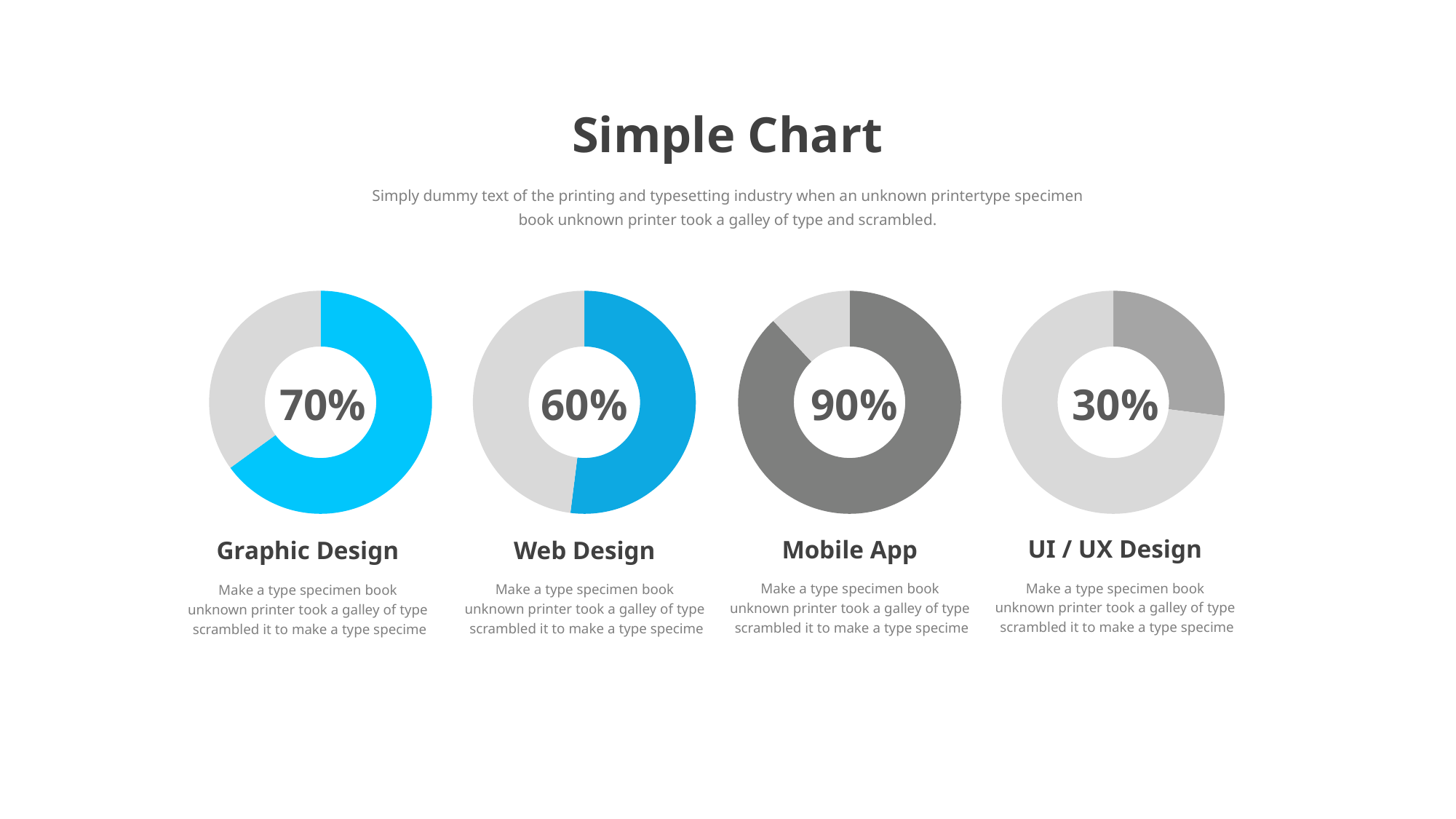
Which of the four donut charts shows the highest percentage? Mobile App Which of the four donut charts shows the lowest percentage? UI / UX Design What is the difference between the Mobile App percentage and the UI / UX Design percentage? 60% What percentage is shown in the UI / UX Design donut chart? 30% What percentage is shown in the Mobile App donut chart? 90% What percentage is shown in the Graphic Design donut chart? 70% How many donut charts are shown on the slide? 4 Which is larger, the Web Design percentage or the Graphic Design percentage? Graphic Design What is the title of the slide containing the four donut charts? Simple Chart What kind of chart is used for each of the four categories on the slide? Donut chart What is the difference between the Graphic Design percentage and the Web Design percentage? 10% What percentage is shown in the Web Design donut chart? 60%